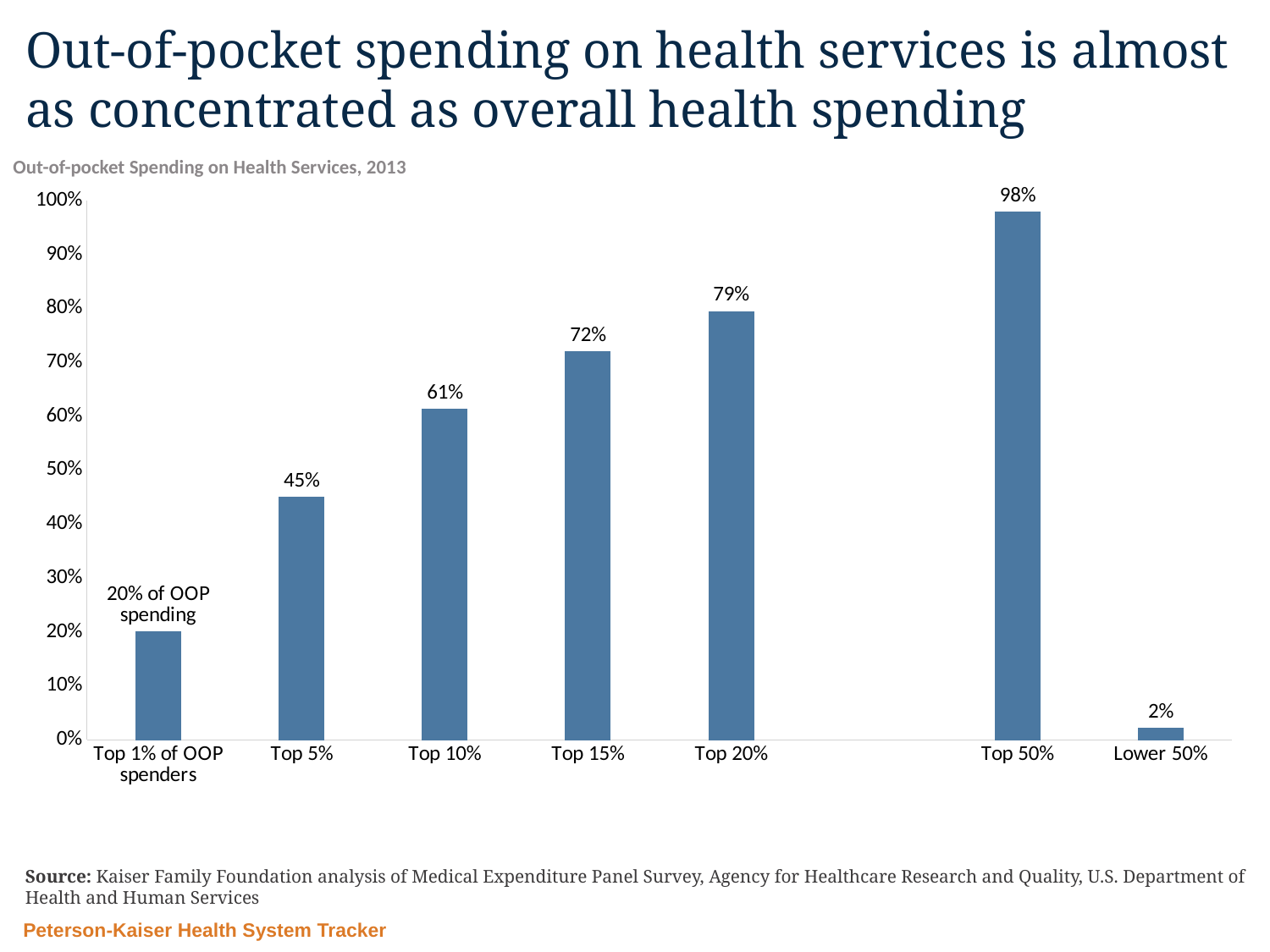
What is the value for Top 5%? 45% What is the value for Lower 50%? 2% What is the difference between the values for Top 15% and Top 10%? 11% What is the value for Top 10%? 61% What kind of chart is this? Bar chart What is the chart's title? Out-of-pocket Spending on Health Services, 2013 How many categories are shown on the x axis? 7 Which category has the lowest value? Lower 50% What is the difference between the values for Top 50% and Lower 50%? 96% Which is larger, the value for Top 5% or the value for Top 15%? Top 15% What is the value for Top 20%? 79% Which category has the highest value? Top 50%